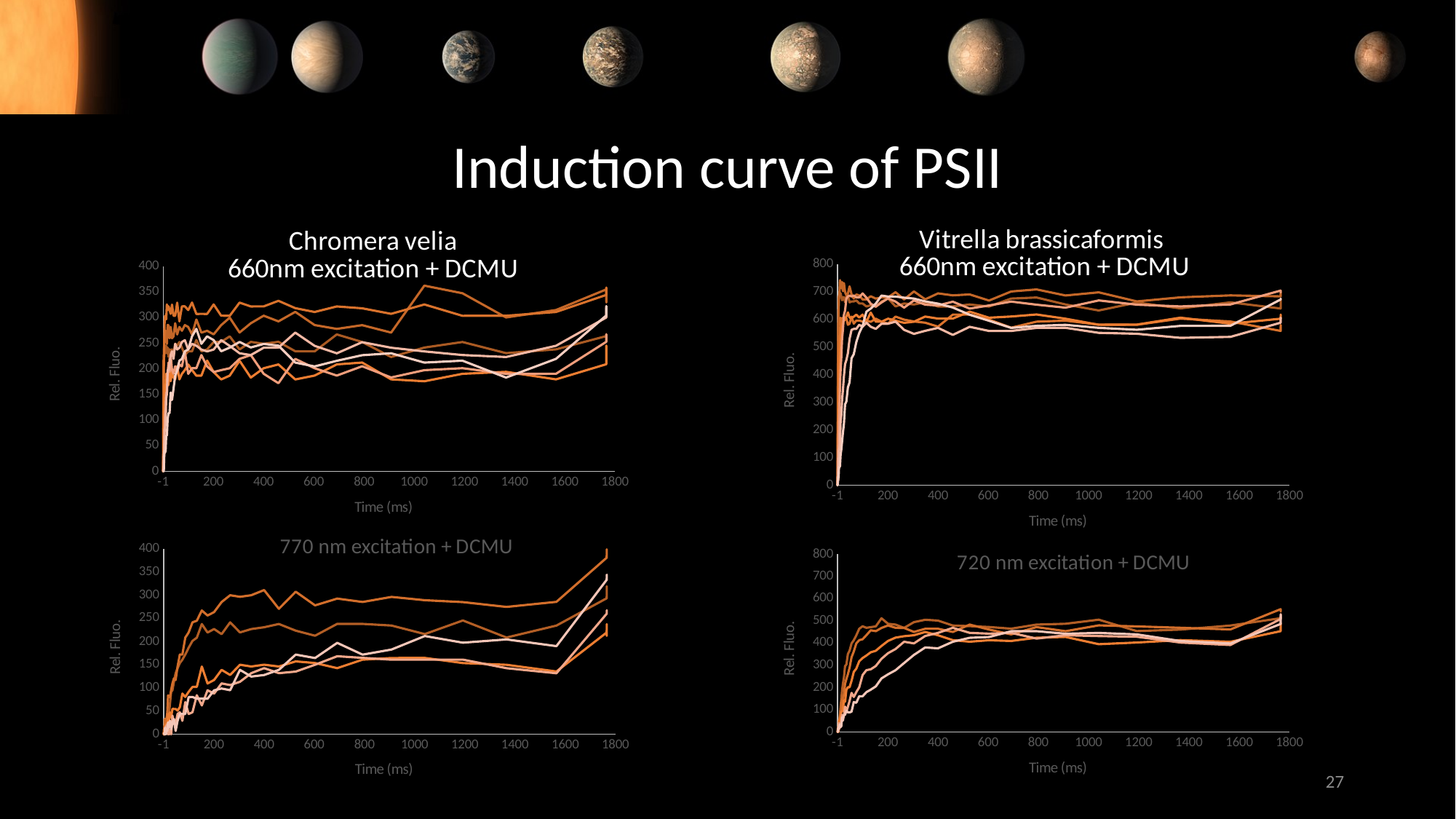
How many charts are shown on the slide? 4 What is the y-axis label of the bottom-left chart titled '770 nm excitation + DCMU'? Rel. Fluo. What kind of chart is the top-left chart titled 'Chromera velia 660nm excitation + DCMU'? line chart In the top-right chart 'Vitrella brassicaformis 660nm excitation + DCMU', are the line values at 1000 ms greater or less than 400? greater In the top-left chart 'Chromera velia 660nm excitation + DCMU', what is the highest tick value shown on the y-axis? 400 In the top-left chart 'Chromera velia 660nm excitation + DCMU', are the line values at 1000 ms greater or less than 100? greater What is the last tick value shown on the x-axis of the bottom-left chart '770 nm excitation + DCMU'? 1800 In the bottom-right chart '720 nm excitation + DCMU', do the lines rise or fall between 0 and 200 ms? rise In the bottom-right chart '720 nm excitation + DCMU', are the line values at 1000 ms greater or less than 600? less What is the title of the top-right chart? Vitrella brassicaformis 660nm excitation + DCMU In the top-right chart 'Vitrella brassicaformis 660nm excitation + DCMU', what is the highest tick value shown on the y-axis? 800 In the bottom-left chart '770 nm excitation + DCMU', do the lines rise or fall between 0 and 200 ms? rise